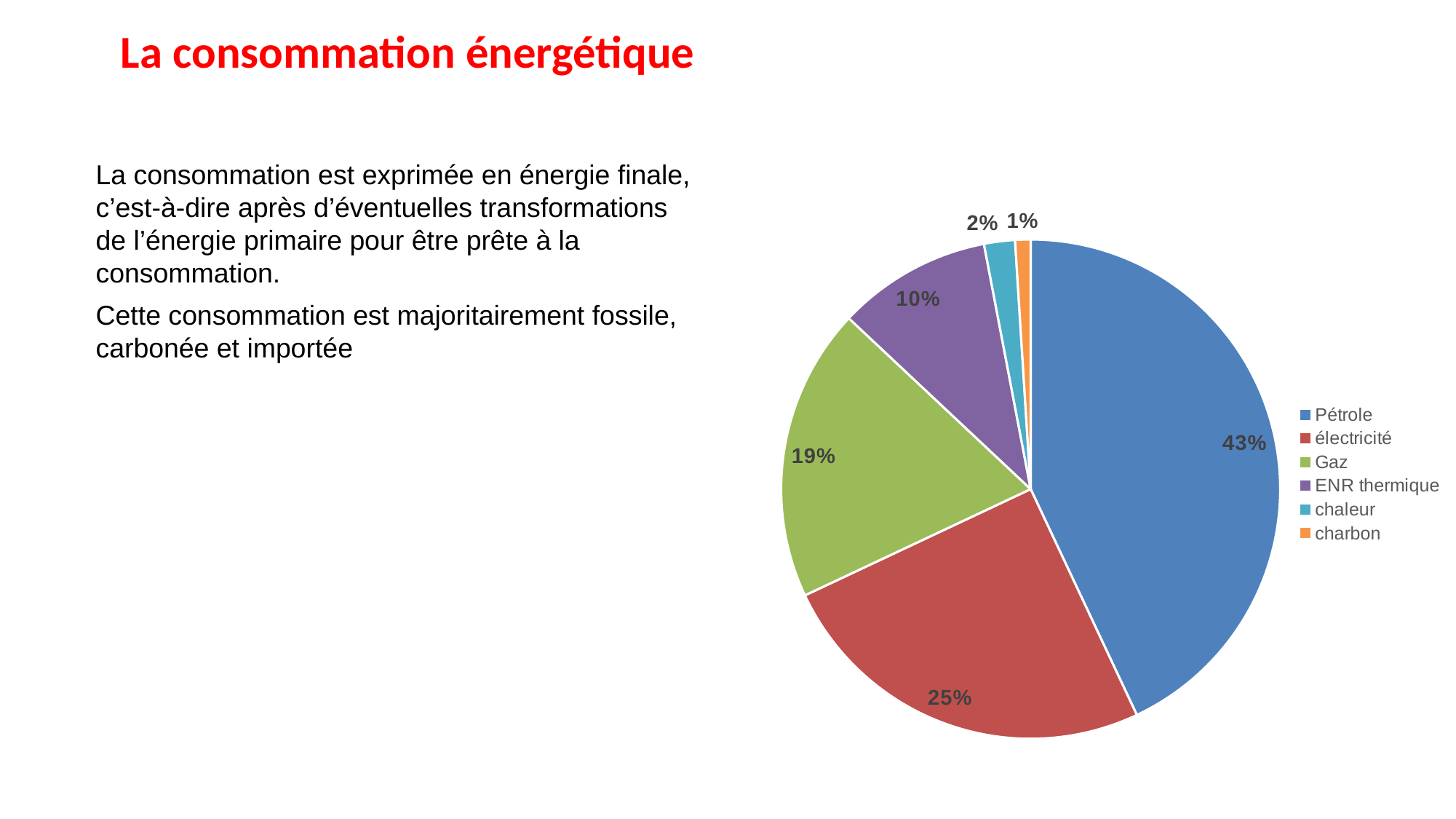
Which is larger, the share of Gaz or the share of ENR thermique? Gaz What is the value shown for charbon? 1% How many categories does the legend list? 6 What is the value shown for ENR thermique? 10% What is the difference between the shares of Pétrole and électricité? 18% Which category has the largest slice of the pie? Pétrole Which category has the smallest slice of the pie? charbon What kind of chart is shown on the slide? pie chart What is the value shown for chaleur? 2% What is the value shown for Gaz? 19% What share of the pie does électricité represent? 25% What share of the pie does Pétrole represent? 43%